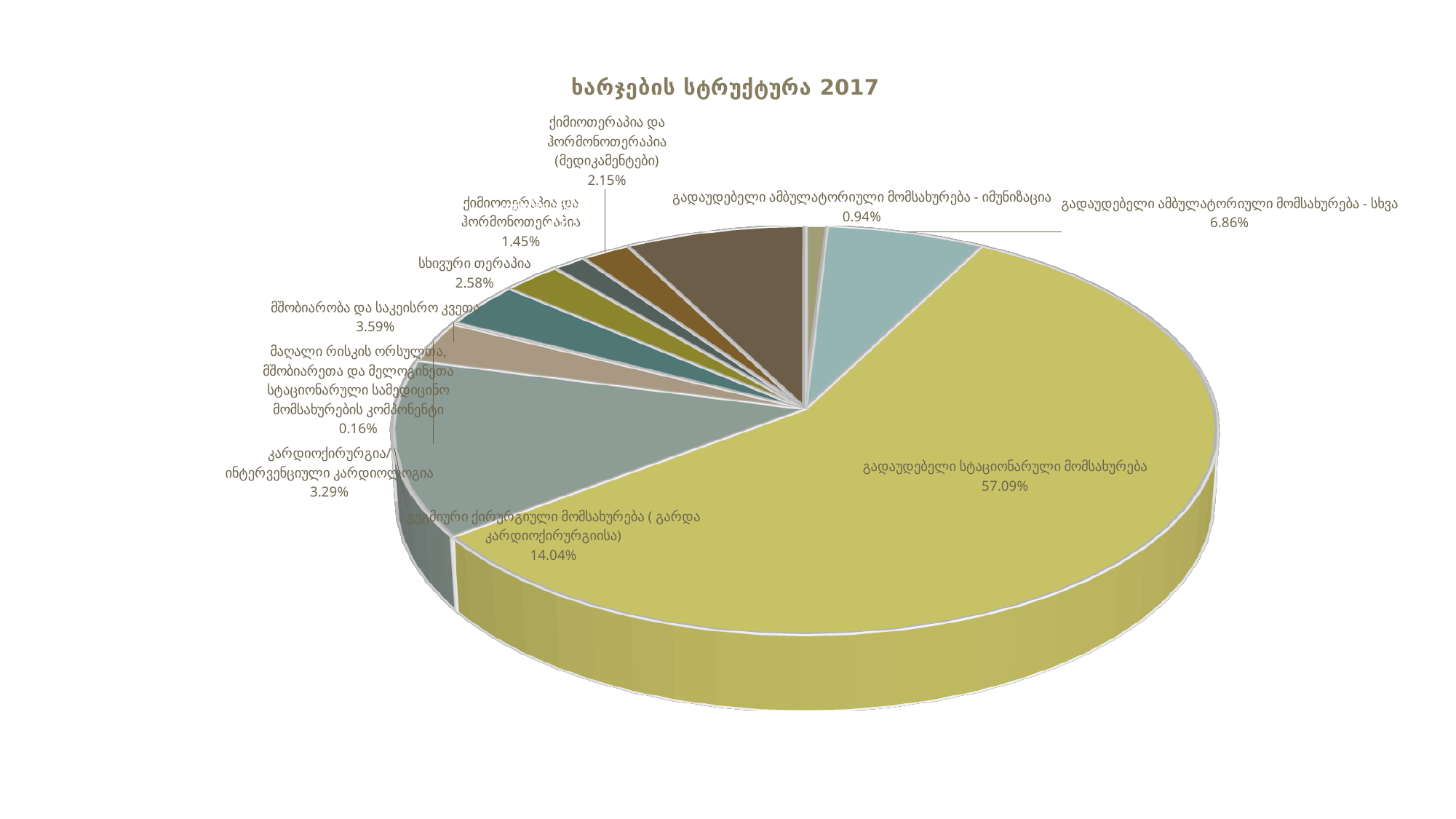
What kind of chart is shown on the slide? pie chart What is the value shown for გადაუდებელი ამბულატორიული მომსახურება - იმუნიზაცია? 0.94% What is the title of the chart? ხარჯების სტრუქტურა 2017 What is the value shown for სხივური თერაპია? 2.58% Which labelled category has the largest share of the pie? გადაუდებელი სტაციონარული მომსახურება What is the difference between the shares of გადაუდებელი სტაციონარული მომსახურება and გეგმიური ქირურგიული მომსახურება (გარდა კარდიოქირურგიისა)? 43.05% What share does გადაუდებელი სტაციონარული მომსახურება have in the pie? 57.09% What is the value shown for გადაუდებელი ამბულატორიული მომსახურება - სხვა? 6.86% Which labelled category has the smallest share of the pie? მაღალი რისკის ორსულთა, მშობიარეთა და მელოგინეთა სტაციონარული სამედიცინო მომსახურების კომპონენტი Which is larger: the share for კარდიოქირურგია/ინტერვენციული კარდიოლოგია or the share for მშობიარობა და საკეისრო კვეთა? მშობიარობა და საკეისრო კვეთა What is the value shown for მშობიარობა და საკეისრო კვეთა? 3.59% What is the value shown for გეგმიური ქირურგიული მომსახურება (გარდა კარდიოქირურგიისა)? 14.04%